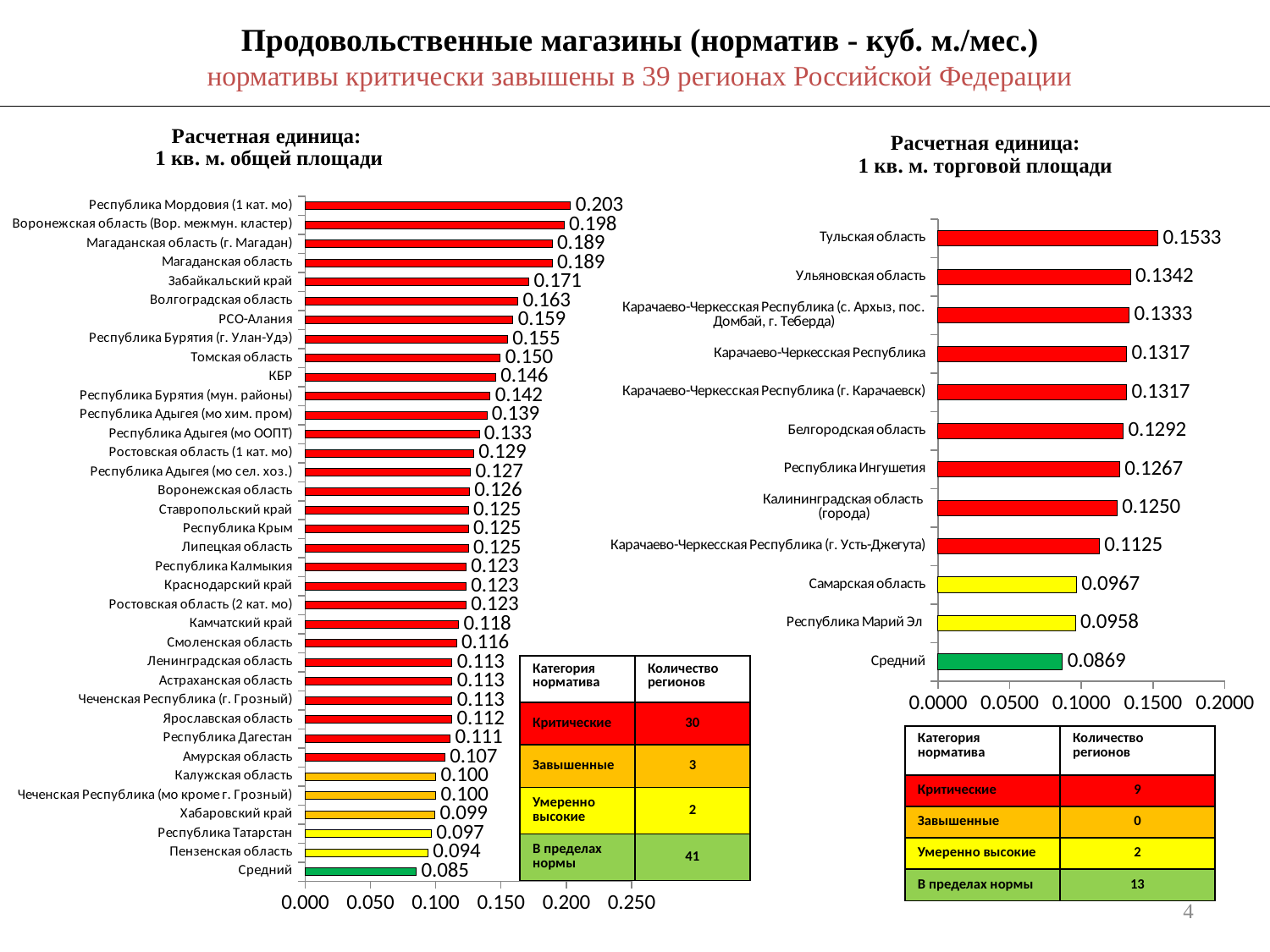
In the left chart (1 кв. м. общей площади), what is the value for Томская область? 0.150 In the right chart (1 кв. м. торговой площади), which region has the highest value? Тульская область What type of chart is used on the right side of the slide (1 кв. м. торговой площади)? Bar chart In the left chart (1 кв. м. общей площади), what is the difference between Забайкальский край and Волгоградская область? 0.008 In the left chart (1 кв. м. общей площади), which is larger: Камчатский край or Смоленская область? Камчатский край In the left chart (1 кв. м. общей площади), which region has the highest value? Республика Мордовия (1 кат. мо) In the right chart (1 кв. м. торговой площади), what is the difference between Тульская область and Ульяновская область? 0.0191 In the left chart (1 кв. м. общей площади), which category has the lowest value? Средний In the right chart (1 кв. м. торговой площади), how many bars are plotted? 12 In the right chart (1 кв. м. торговой площади), what is the value for Белгородская область? 0.1292 In the left chart (1 кв. м. общей площади), what is the value for Хабаровский край? 0.099 In the right chart (1 кв. м. торговой площади), what is the value for Средний? 0.0869